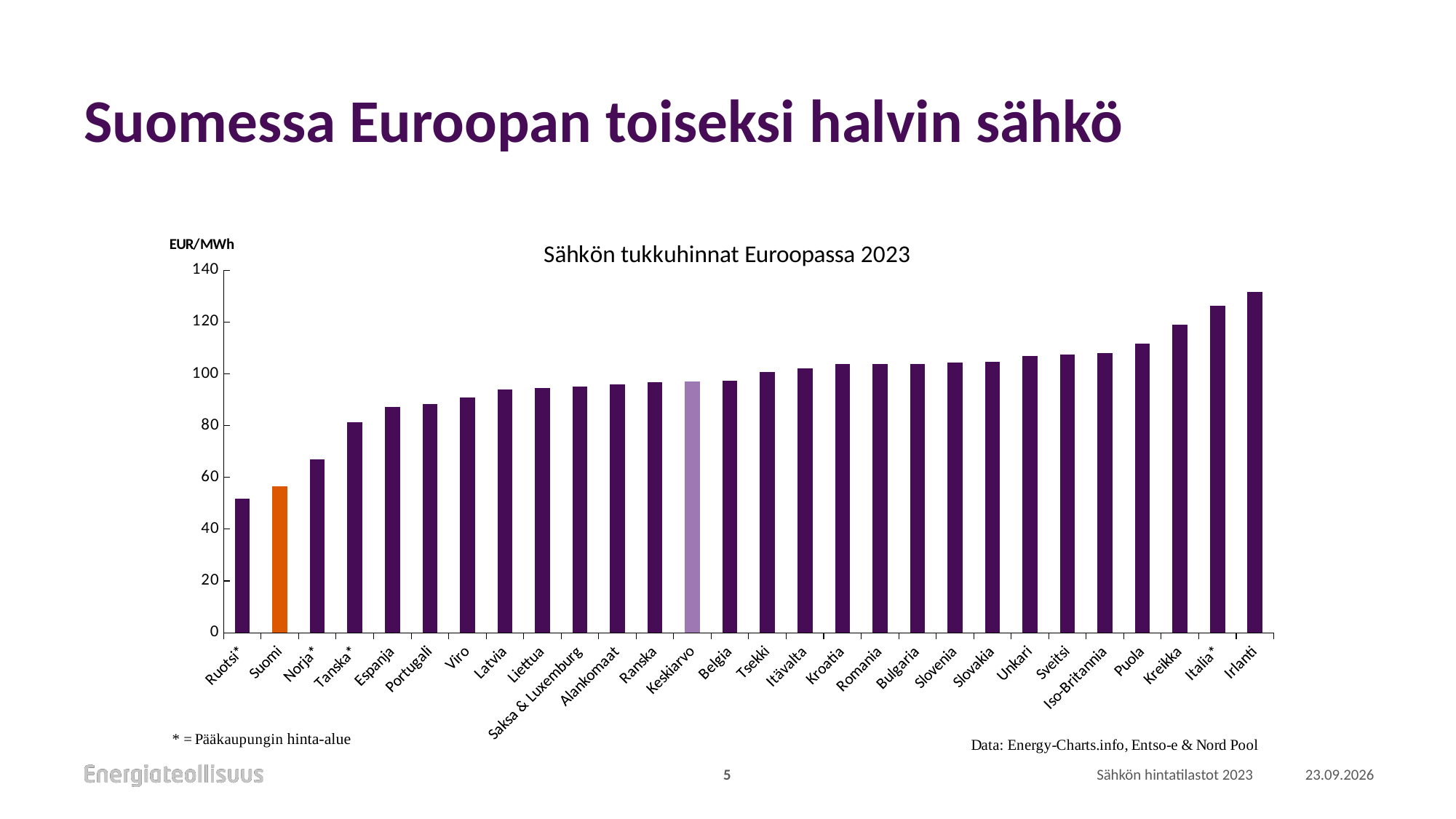
Which category has the highest value in the chart? Irlanti Is the value for Ruotsi* greater or less than 60? less Is the value for Puola greater or less than 100? greater Is the value for Irlanti greater or less than 120? greater How many categories are plotted on the x axis? 28 What unit is shown on the y axis of the chart? EUR/MWh What is the title of the chart? Sähkön tukkuhinnat Euroopassa 2023 What kind of chart is shown on the slide? bar chart Which is larger, the value for Suomi or the value for Norja*? Norja* Do the values rise or fall from left to right along the x axis? rise Which category has the lowest value in the chart? Ruotsi*